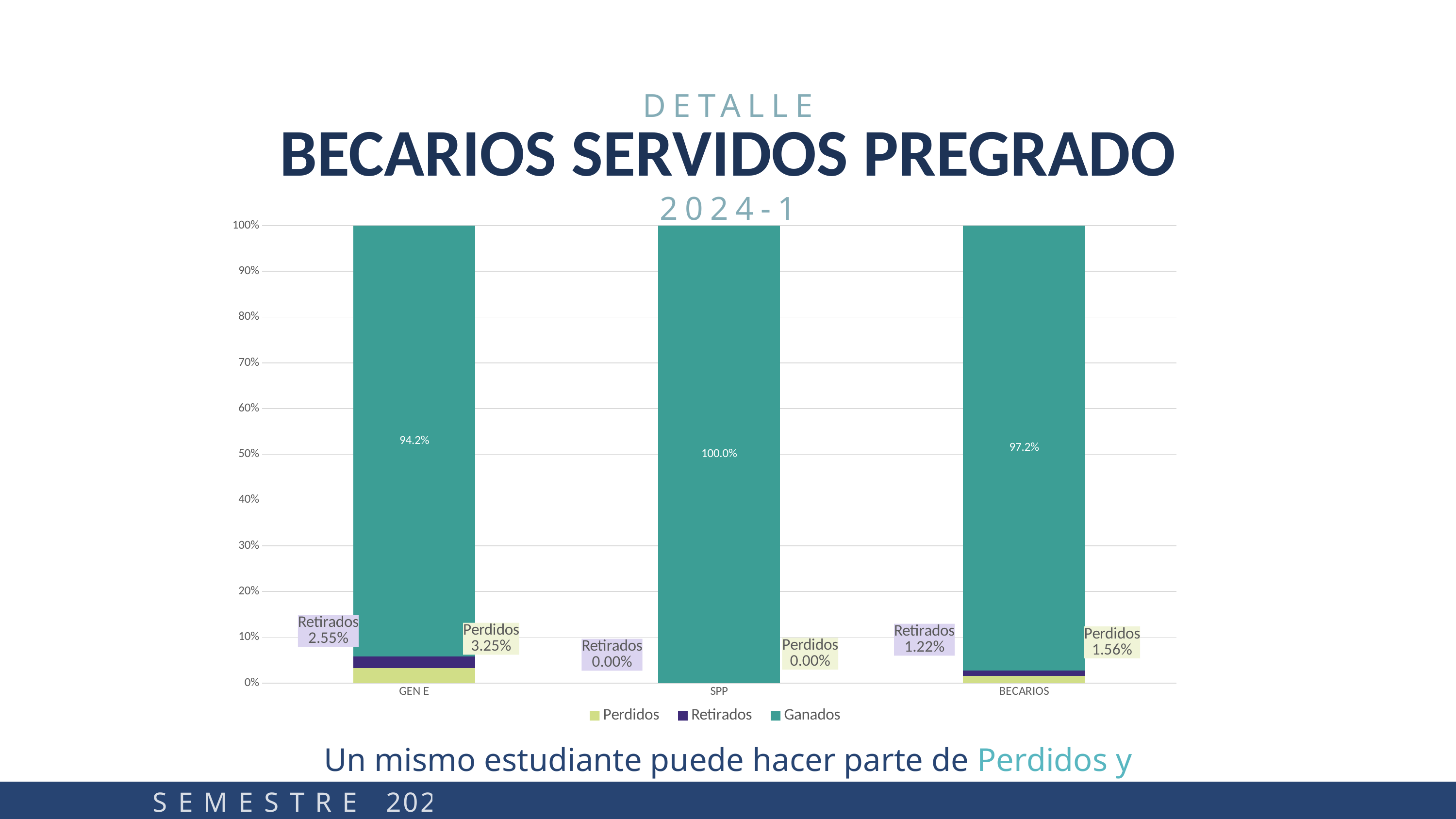
What is the difference between the Ganados values for BECARIOS and GEN E? 3.0% Which is larger, the Retirados value for GEN E or for BECARIOS? GEN E What is the Perdidos value for GEN E? 3.25% How many categories are shown on the x axis? 3 What is the Ganados value for GEN E? 94.2% Which category has the lowest Ganados value? GEN E What kind of chart is shown on the slide? Stacked bar chart What is the Perdidos value for BECARIOS? 1.56% What is the Retirados value for BECARIOS? 1.22% How many series does the legend list? 3 Which category has the highest Ganados value? SPP What is the Ganados value for SPP? 100.0%